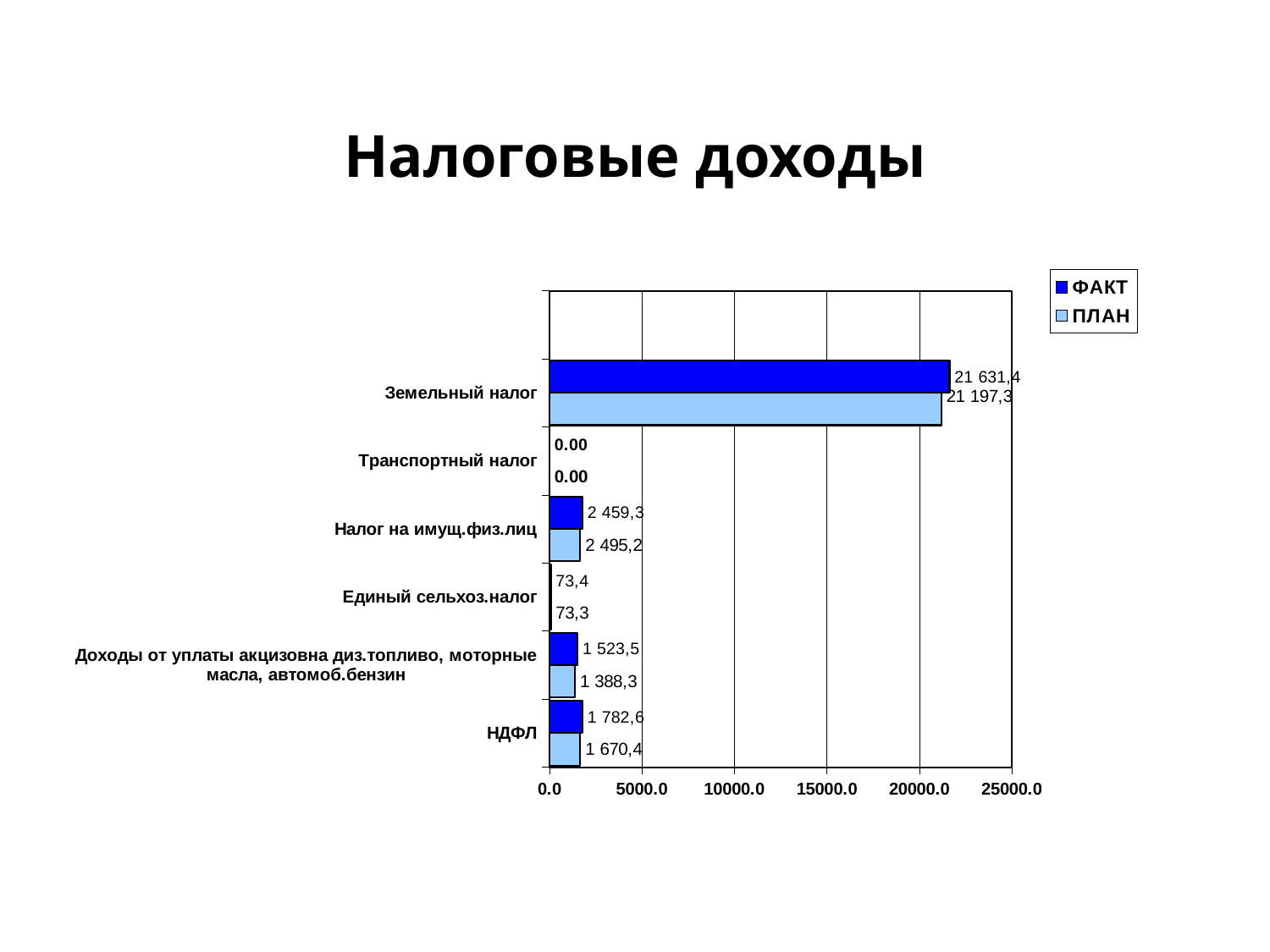
What is the difference between the ФАКТ and ПЛАН values for Земельный налог? 434,1 Which category has the lowest ПЛАН value? Транспортный налог What is the ФАКТ value for НДФЛ? 1 782,6 What type of chart is shown on the slide? bar chart What is the ФАКТ value for Земельный налог? 21 631,4 Which category has the highest ФАКТ value? Земельный налог For Налог на имущ.физ.лиц, which is larger: the ФАКТ value or the ПЛАН value? ПЛАН How many categories are shown on the chart? 6 What is the title of the chart? Налоговые доходы How many series does the legend list? 2 What is the ПЛАН value for Земельный налог? 21 197,3 What is the ПЛАН value for Налог на имущ.физ.лиц? 2 495,2